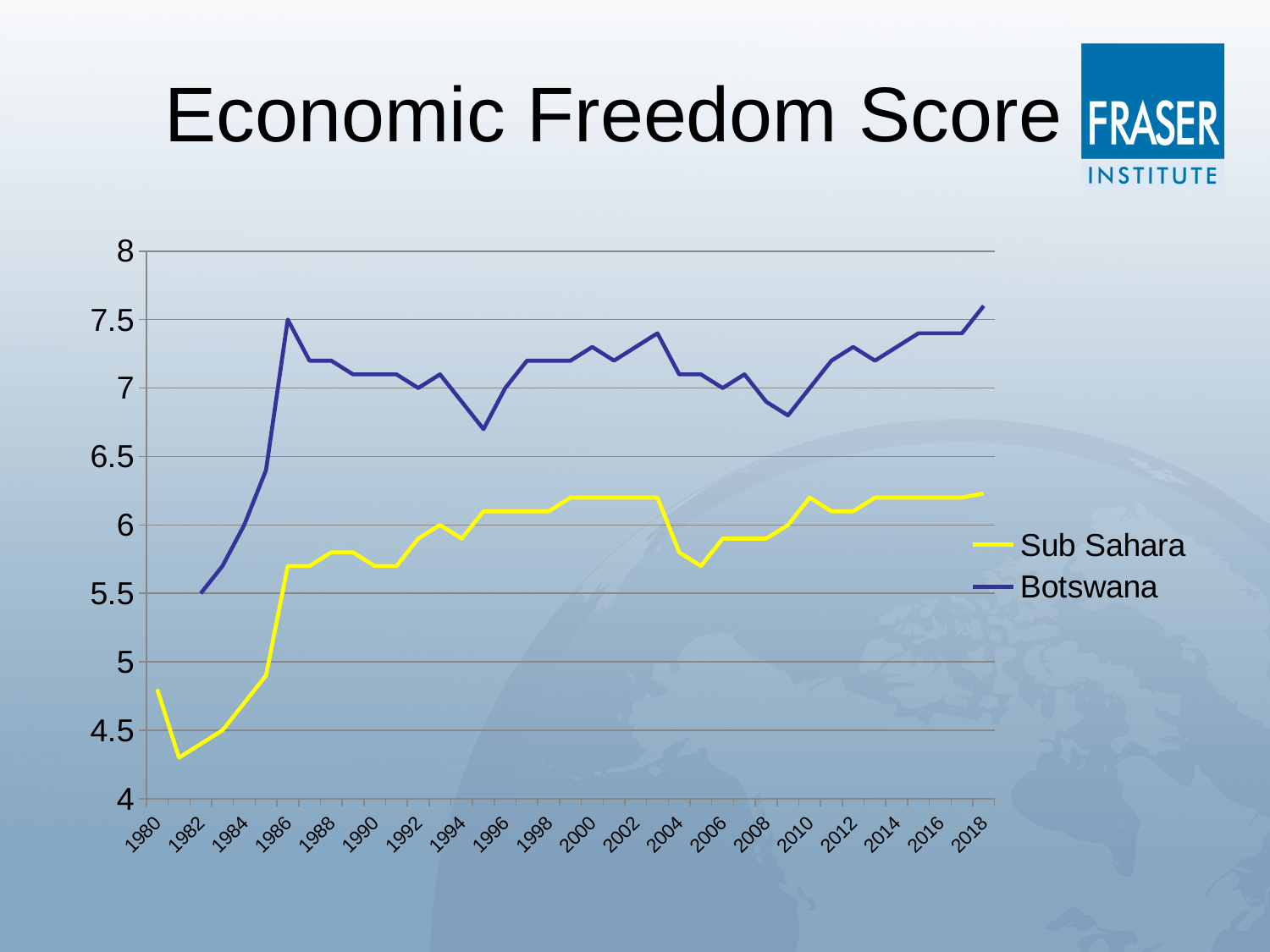
What kind of chart is shown on the slide? line chart In which year is the Sub Sahara score lowest? 1981 In which year is the Botswana score lowest? 1982 Is the Sub Sahara value for 1981 greater or less than 4.5? less How many series does the legend list? 2 Is the Botswana value for 2018 greater or less than 7.5? greater Which colour is the Botswana line? blue Does the Sub Sahara score overall rise or fall from 1980 to 2018? rise What is the title of the chart? Economic Freedom Score Which series has the higher value in 2000, Sub Sahara or Botswana? Botswana What is the Botswana score in 1982? 5.5